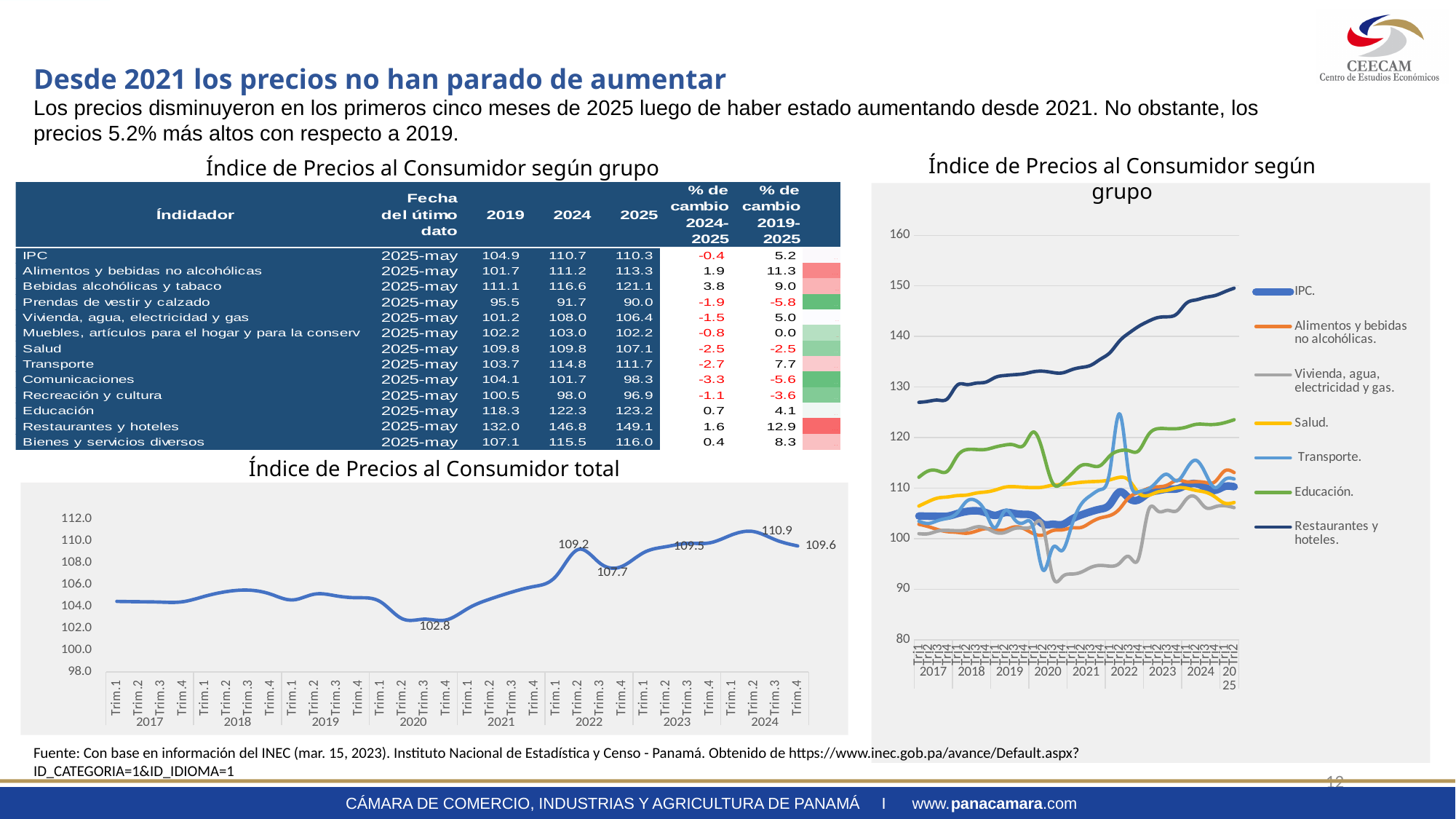
In the 'Índice de Precios al Consumidor total' chart, what is the difference between the labelled values 110.9 (2024 Trim.2) and 102.8 (2020 Trim.3)? 8.1 In the 'Índice de Precios al Consumidor total' chart, which is larger: the value at Trim.2 of 2024 or the value at Trim.4 of 2024? Trim.2 of 2024 (110.9) In the 'Índice de Precios al Consumidor total' chart, what is the value labelled at Trim.2 of 2022? 109.2 What kind of chart is the 'Índice de Precios al Consumidor total' chart? line chart How many series does the legend of the 'Índice de Precios al Consumidor según grupo' chart list? 7 In the 'Índice de Precios al Consumidor total' chart, do the values rise or fall across the four quarters of 2021? rise In the 'Índice de Precios al Consumidor total' chart, what is the value labelled at Trim.3 of 2020? 102.8 In the 'Índice de Precios al Consumidor total' chart, what is the value labelled at Trim.4 of 2024? 109.6 In the 'Índice de Precios al Consumidor según grupo' chart, which series has the highest value at the end of the period (2025)? Restaurantes y hoteles How many years are shown on the x axis of the 'Índice de Precios al Consumidor total' chart? 8 In the 'Índice de Precios al Consumidor según grupo' chart, is the value for Restaurantes y hoteles in 2025 greater or less than 140? greater